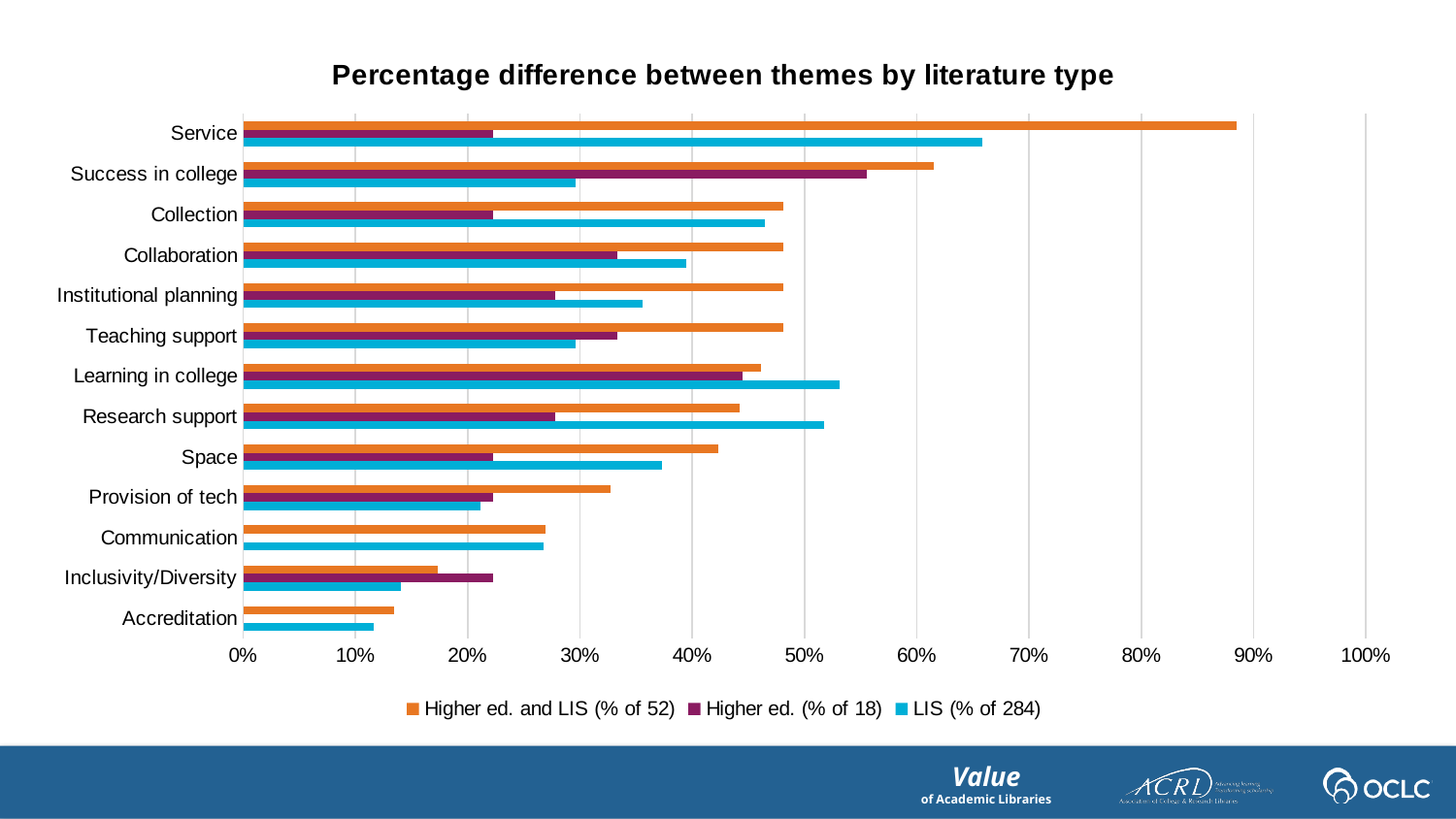
Is the 'LIS (% of 284)' value for Service greater or less than 60%? greater What kind of chart is shown on the slide? bar chart Which theme has the highest value for the 'Higher ed. (% of 18)' series? Success in college Which theme has the highest value for the 'Higher ed. and LIS (% of 52)' series? Service Is the 'Higher ed. and LIS (% of 52)' value for Service greater or less than 80%? greater How many series does the chart's legend list? 3 Which theme has the highest value for the 'LIS (% of 284)' series? Service What is the title of the chart? Percentage difference between themes by literature type Is the 'Higher ed. and LIS (% of 52)' value for Accreditation greater or less than 20%? less How many themes (categories) are listed on the vertical axis of the chart? 13 Which theme has the lowest value for the 'Higher ed. and LIS (% of 52)' series? Accreditation For Success in college, which series has the larger value: 'Higher ed. and LIS (% of 52)' or 'LIS (% of 284)'? Higher ed. and LIS (% of 52)